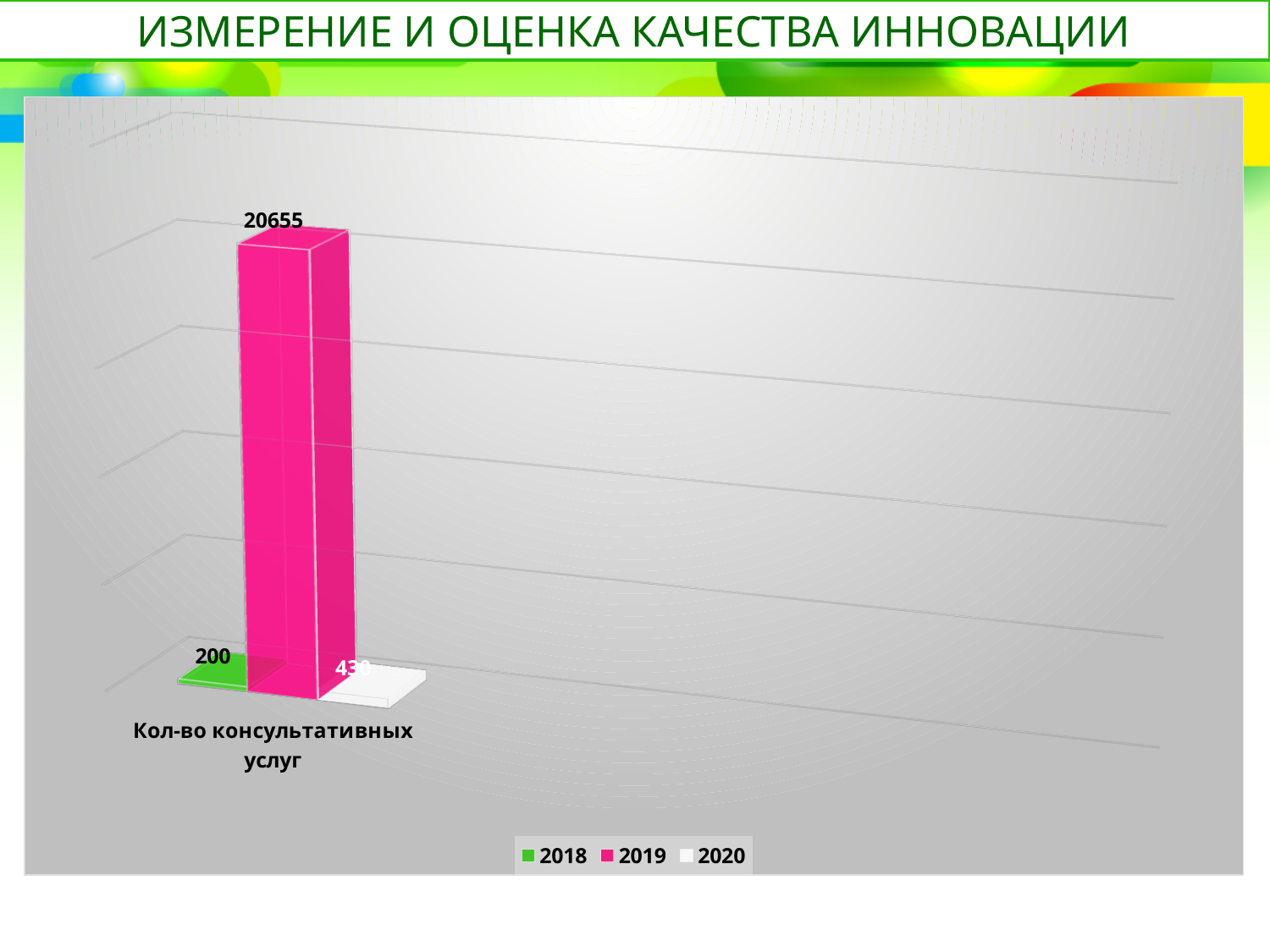
What is the difference between the 2019 and 2018 values for "Кол-во консультативных услуг"? 20455 How many categories are shown on the x axis? 1 Which is larger, the value for 2020 or the value for 2018? 2020 Which year has the highest value for "Кол-во консультативных услуг"? 2019 What is the value for 2019 for "Кол-во консультативных услуг"? 20655 What is the difference between the 2020 and 2018 values for "Кол-во консультативных услуг"? 230 How many series does the legend list? 3 What is the value for 2020 for "Кол-во консультативных услуг"? 430 What is the value for 2018 for "Кол-во консультативных услуг"? 200 What kind of chart is shown on the slide? Bar chart Which colour represents the 2019 series in the legend? Pink Which year has the lowest value for "Кол-во консультативных услуг"? 2018